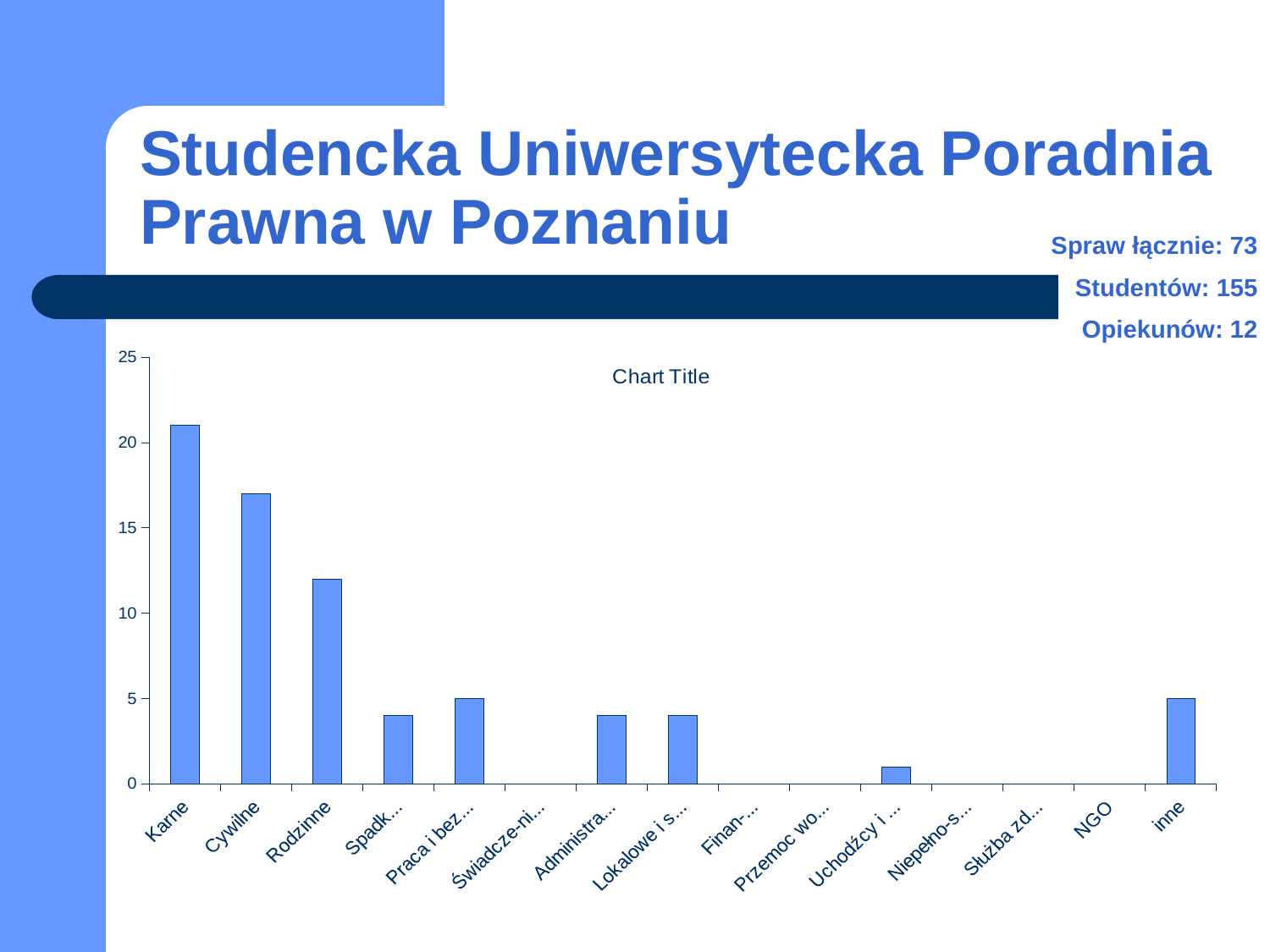
Is the value for Rodzinne greater or less than 10? greater Which is larger, the value for Rodzinne or the value for inne? Rodzinne Which is larger, the value for Karne or the value for Cywilne? Karne Is the value for Karne greater or less than 20? greater What is the title shown on the chart? Chart Title Is the value for Rodzinne greater or less than 15? less What kind of chart is shown on the slide? bar chart How many categories are shown on the x axis of the chart? 15 What is the value for the category inne? 5 Which category has the highest value in the chart? Karne